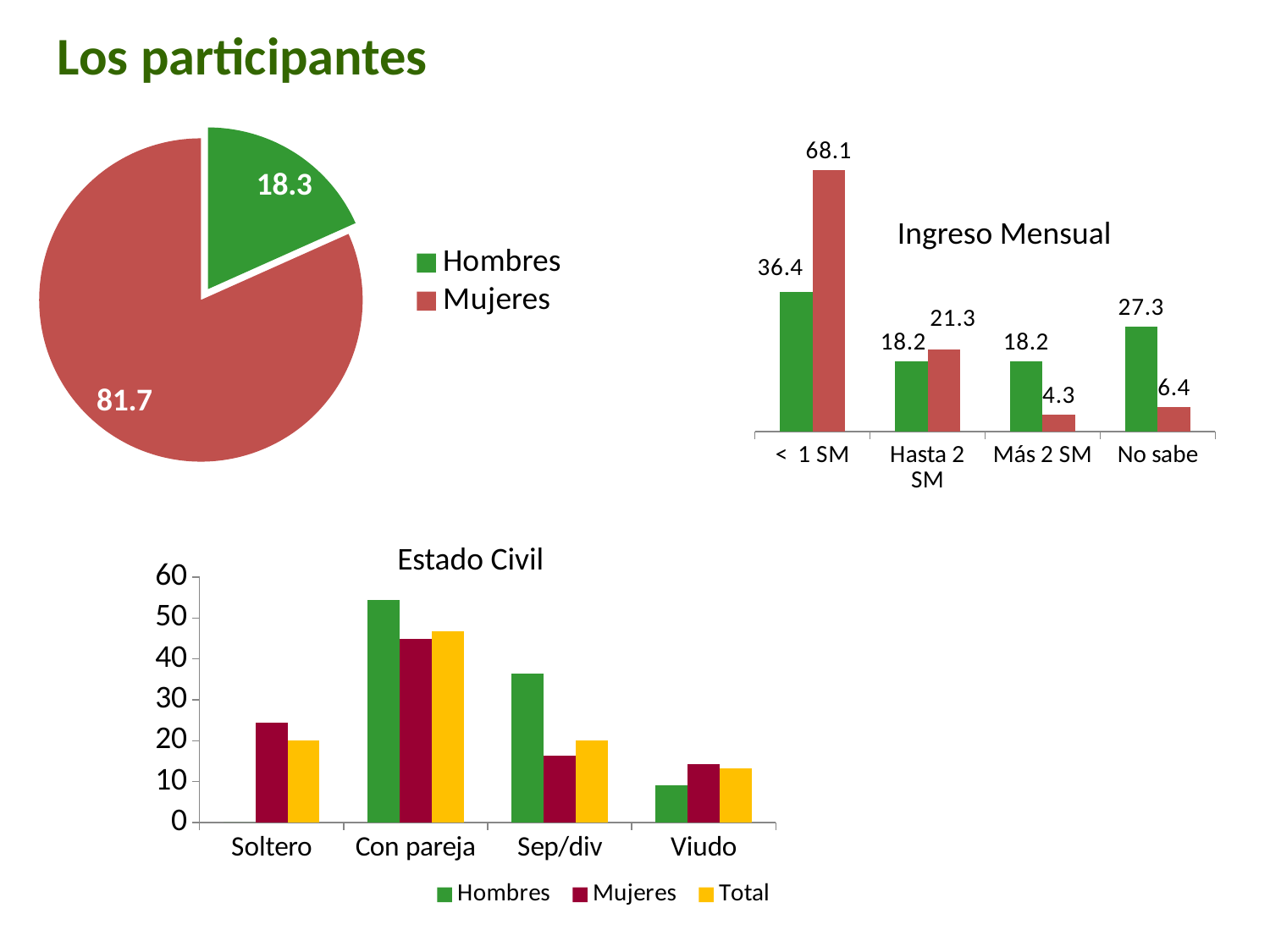
In the pie chart, what is the value for Mujeres? 81.7 In the Ingreso Mensual chart, what is the value for Hombres in the No sabe category? 27.3 How many categories are shown on the x axis of the Ingreso Mensual chart? 4 In the Ingreso Mensual chart, what is the difference between the Mujeres and Hombres values in the < 1 SM category? 31.7 In the Estado Civil chart, which is larger in the Sep/div category, Hombres or Mujeres? Hombres In the Estado Civil chart, is the value for Hombres in the Con pareja category greater or less than 50? greater In the pie chart, what is the value for Hombres? 18.3 In the Ingreso Mensual chart, what is the value for Mujeres in the < 1 SM category? 68.1 In the Ingreso Mensual chart, which category has the lowest value for Mujeres? Más 2 SM How many series does the legend of the Estado Civil chart list? 3 What kind of chart is the chart at the top left of the slide? pie chart In the Ingreso Mensual chart, which is larger in the Hasta 2 SM category, Hombres or Mujeres? Mujeres